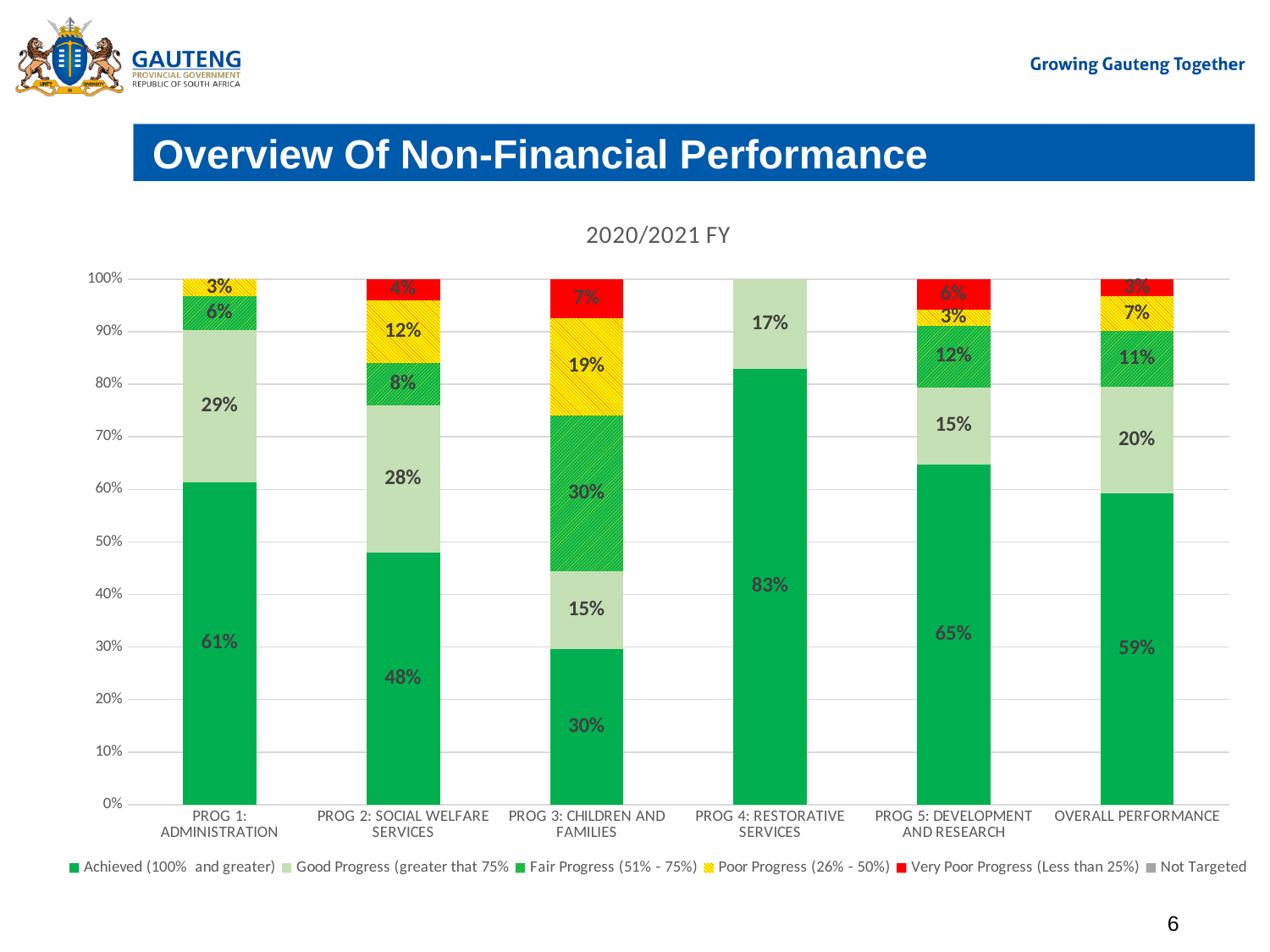
Which programme has the lowest Achieved (100% and greater) share? PROG 3: CHILDREN AND FAMILIES What is the Achieved (100% and greater) value for PROG 4: RESTORATIVE SERVICES? 83% What type of chart is shown on the slide? Stacked bar chart Which has a larger Achieved share, PROG 2: SOCIAL WELFARE SERVICES or PROG 5: DEVELOPMENT AND RESEARCH? PROG 5: DEVELOPMENT AND RESEARCH What is the Good Progress value for PROG 1: ADMINISTRATION? 29% How many categories are shown on the x axis of the chart? 6 What is the Very Poor Progress value for PROG 5: DEVELOPMENT AND RESEARCH? 6% What is the difference in percentage points between the Achieved share of PROG 4: RESTORATIVE SERVICES and PROG 1: ADMINISTRATION? 22 percentage points How many series does the chart legend list? 6 What is the Achieved value for OVERALL PERFORMANCE? 59% Which programme has the highest Achieved (100% and greater) share? PROG 4: RESTORATIVE SERVICES What is the Poor Progress (26% - 50%) value for PROG 3: CHILDREN AND FAMILIES? 19%